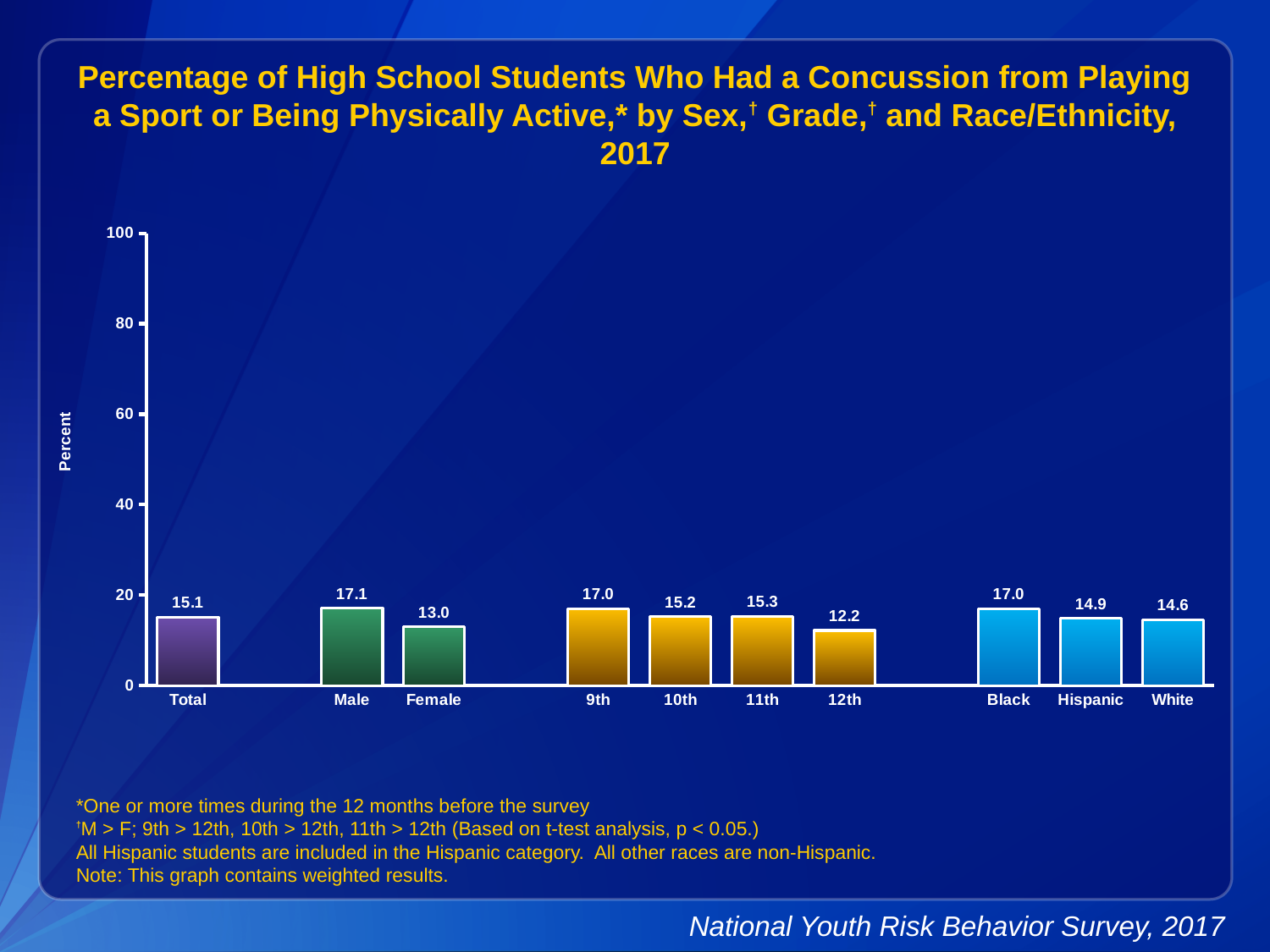
Which is larger, the value for Black or the value for White? Black What is the value for Female? 13.0 What is the difference between the Male and Female values? 4.1 What is the difference between the 9th grade and 12th grade values? 4.8 What is the value for 12th grade? 12.2 What kind of chart is shown on the slide? bar chart What is the value for Total? 15.1 What is the value for Hispanic? 14.9 Which category has the lowest value? 12th Is the value for Male greater or less than 20? less What is the label on the vertical axis? Percent How many bars are shown in the chart? 10